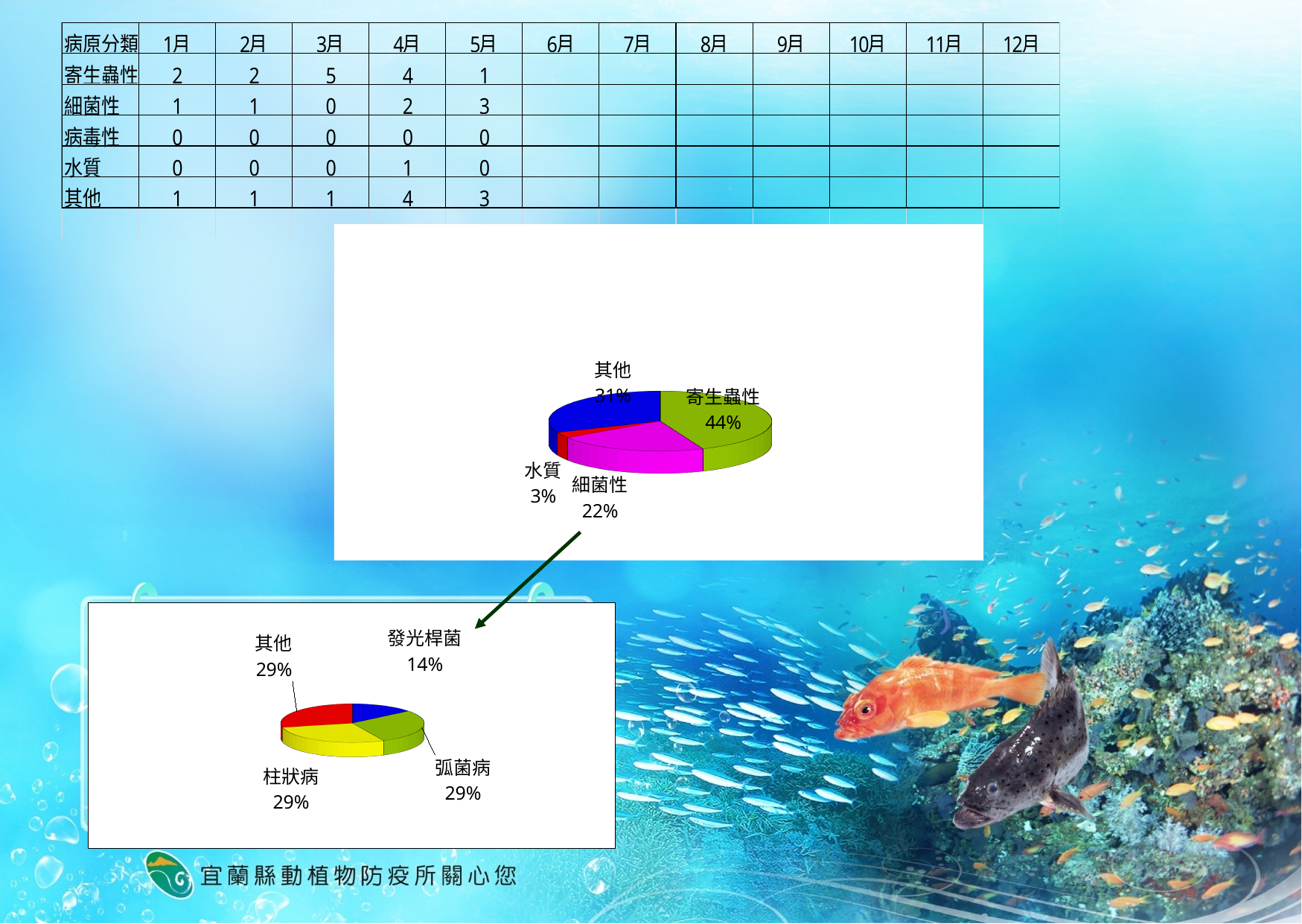
In the upper pie chart, what is the difference in percentage points between 寄生蟲性 and 細菌性? 22 In the upper pie chart, which category has the smallest slice? 水質 In the lower pie chart, how many slices are labelled? 4 In the upper pie chart, what share does 寄生蟲性 have? 44% In the lower pie chart, what share does 發光桿菌 have? 14% In the upper pie chart, what share does 水質 have? 3% In the upper pie chart, how many slices are labelled? 4 In the lower pie chart, what colour is the 柱狀病 slice? yellow In the upper pie chart, which category has the largest slice? 寄生蟲性 In the lower pie chart, which category has the smallest slice? 發光桿菌 What kind of chart is the lower chart on the slide? pie chart